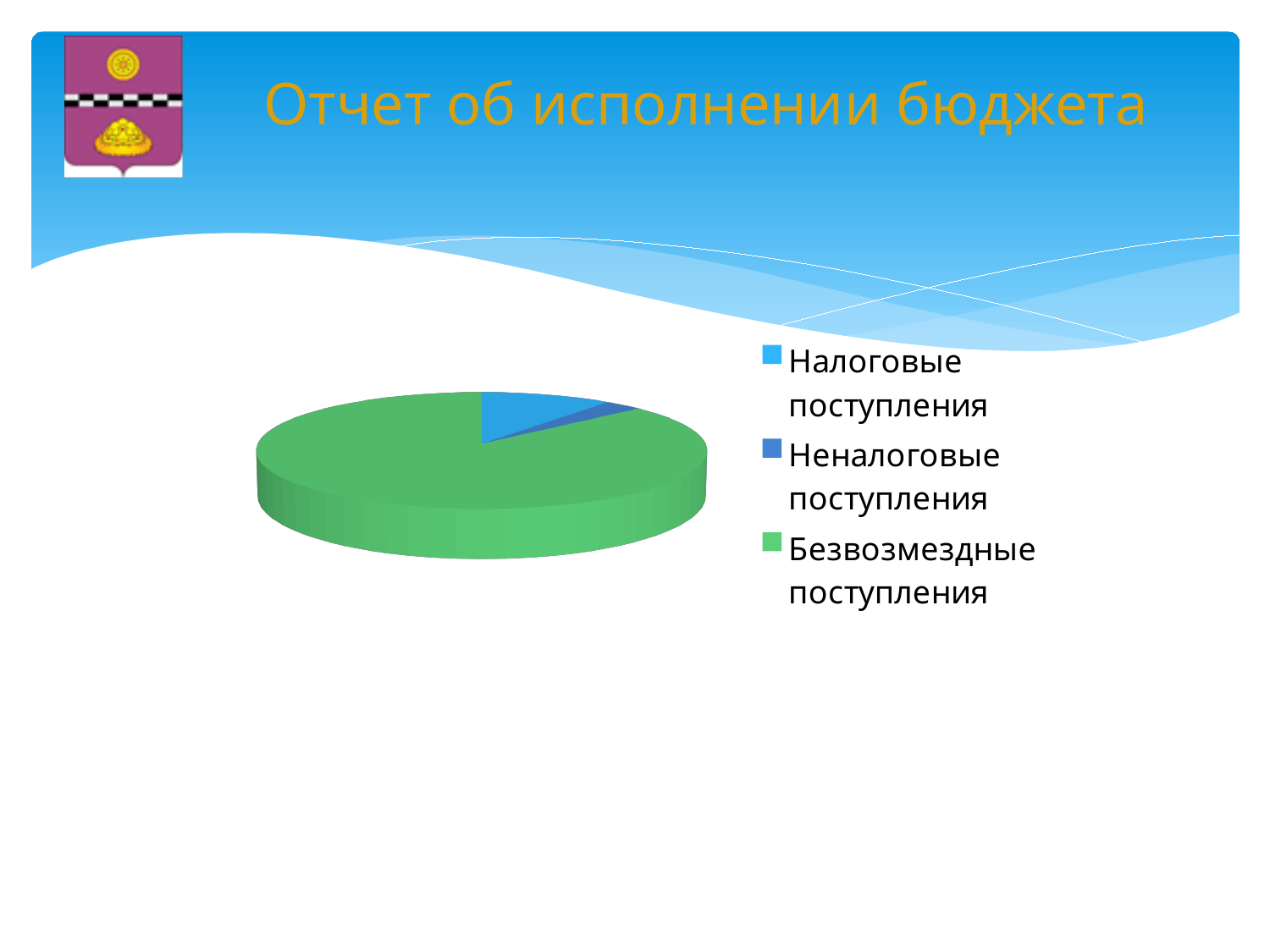
How many entries does the legend of the pie chart list? 3 Which category has the largest slice of the pie chart? Безвозмездные поступления What is the title of the slide containing the pie chart? Отчет об исполнении бюджета Which category has the smallest slice of the pie chart? Неналоговые поступления Which slice is larger: Безвозмездные поступления or Налоговые поступления? Безвозмездные поступления How many slices does the pie chart have? 3 Does the slice for Безвозмездные поступления take up more or less than half of the pie? more Which slice is larger: Налоговые поступления or Неналоговые поступления? Налоговые поступления What kind of chart is shown on the slide? pie chart What colour is the slice for Безвозмездные поступления? green